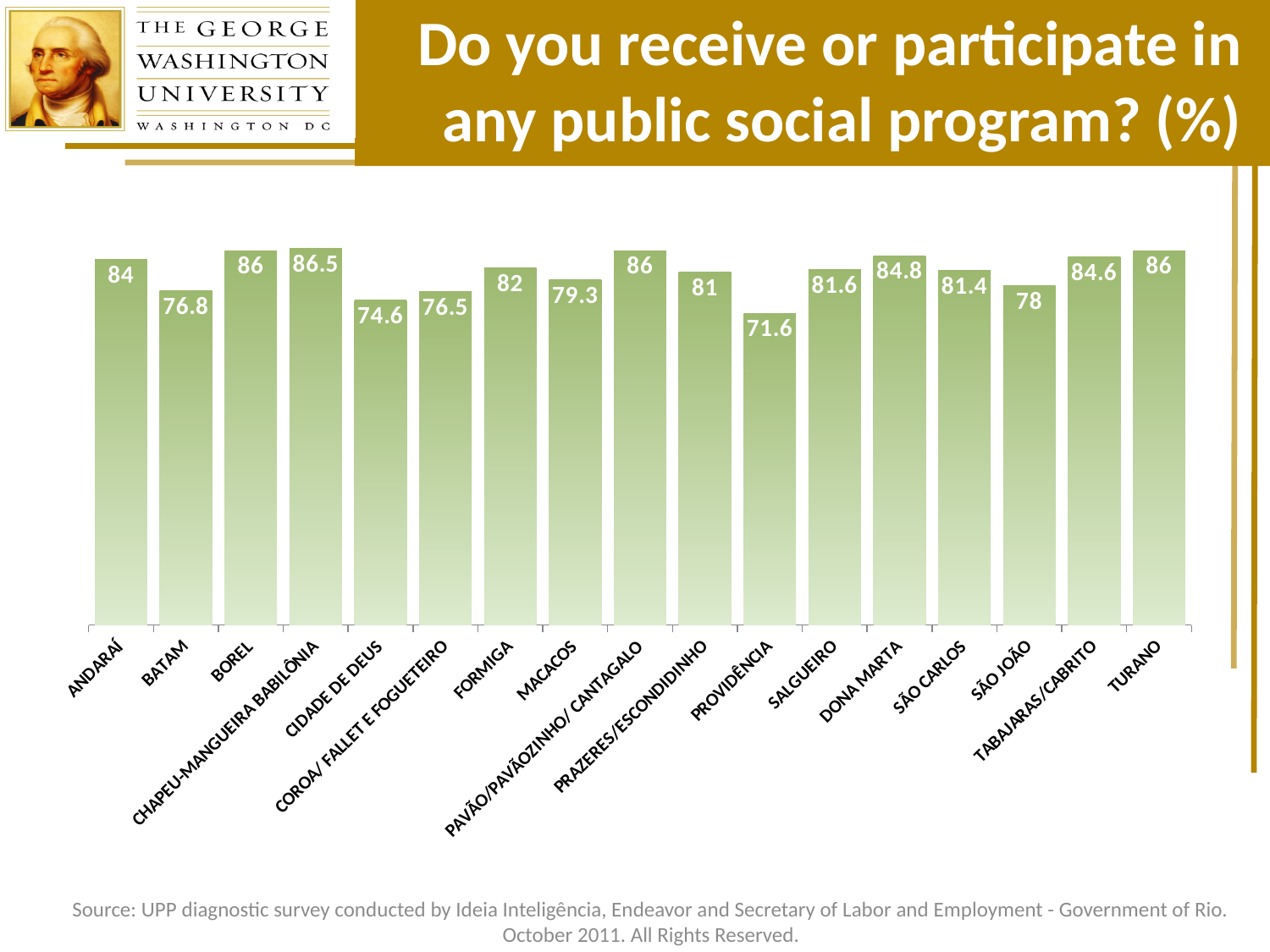
What is the difference between the values for CHAPEU-MANGUEIRA BABILÔNIA and PROVIDÊNCIA? 14.9 Which is larger, the value for FORMIGA or the value for SÃO JOÃO? FORMIGA What is the value for PROVIDÊNCIA? 71.6 What is the value for DONA MARTA? 84.8 Which category has the lowest value? PROVIDÊNCIA What is the value for CIDADE DE DEUS? 74.6 What is the difference between the values for BOREL and BATAM? 9.2 What is the title of the chart? Do you receive or participate in any public social program? (%) What kind of chart is shown on the slide? Bar chart What is the value for MACACOS? 79.3 How many categories are shown in the chart? 17 Which category has the highest value? CHAPEU-MANGUEIRA BABILÔNIA